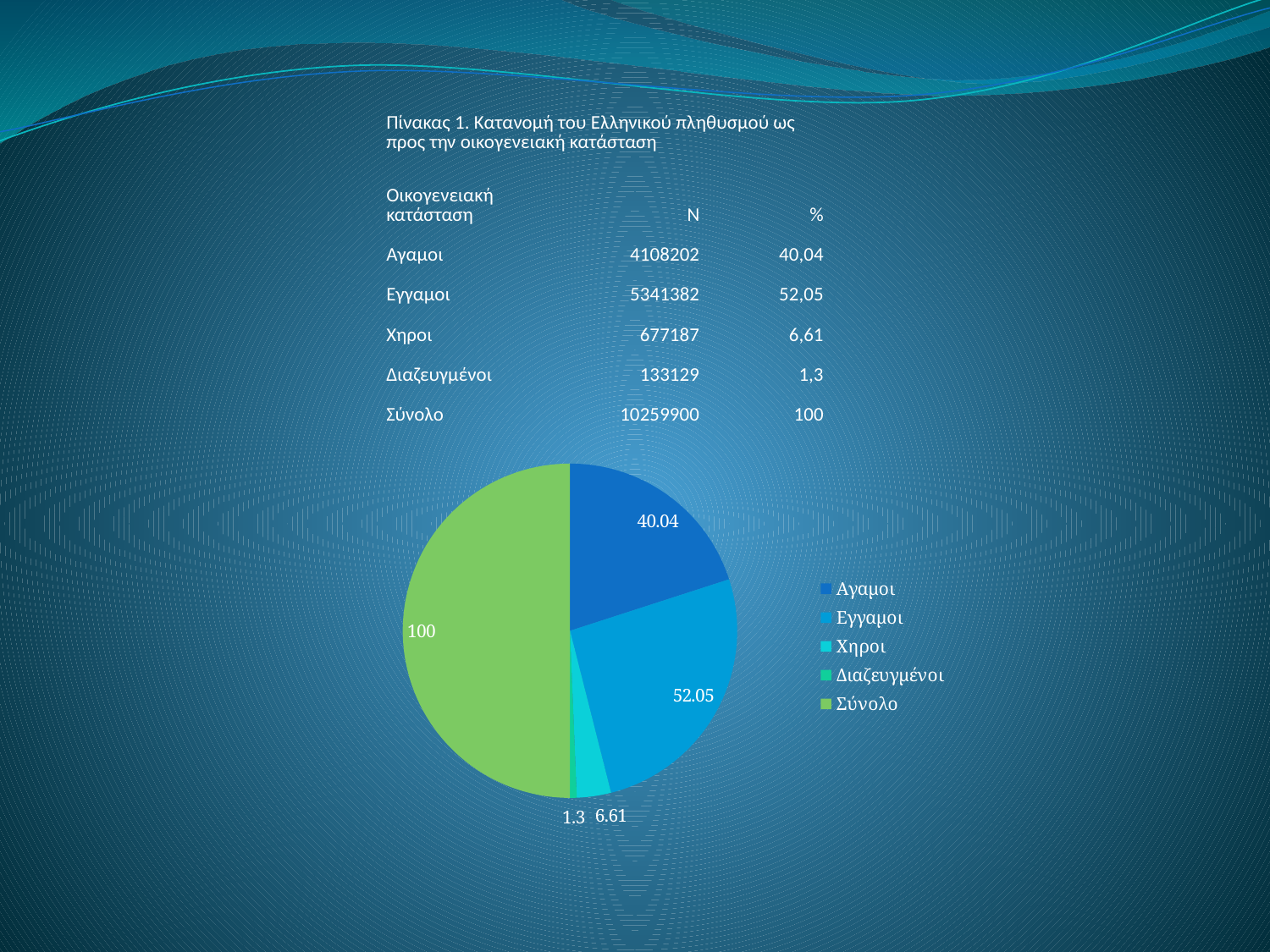
What is the difference between the Εγγαμοι and Αγαμοι values in the pie chart? 12.01 What kind of chart is shown on the slide? pie chart Which slice of the pie chart has the smallest value? Διαζευγμένοι Which slice of the pie chart has the largest value? Σύνολο What is the value shown for the Σύνολο slice of the pie chart? 100 What is the value shown for the Αγαμοι slice of the pie chart? 40.04 What is the value shown for the Διαζευγμένοι slice of the pie chart? 1.3 What is the value shown for the Χηροι slice of the pie chart? 6.61 Which is larger in the pie chart, Αγαμοι or Εγγαμοι? Εγγαμοι How many slices does the pie chart have? 5 What is the value shown for the Εγγαμοι slice of the pie chart? 52.05 How many entries does the legend of the pie chart list? 5